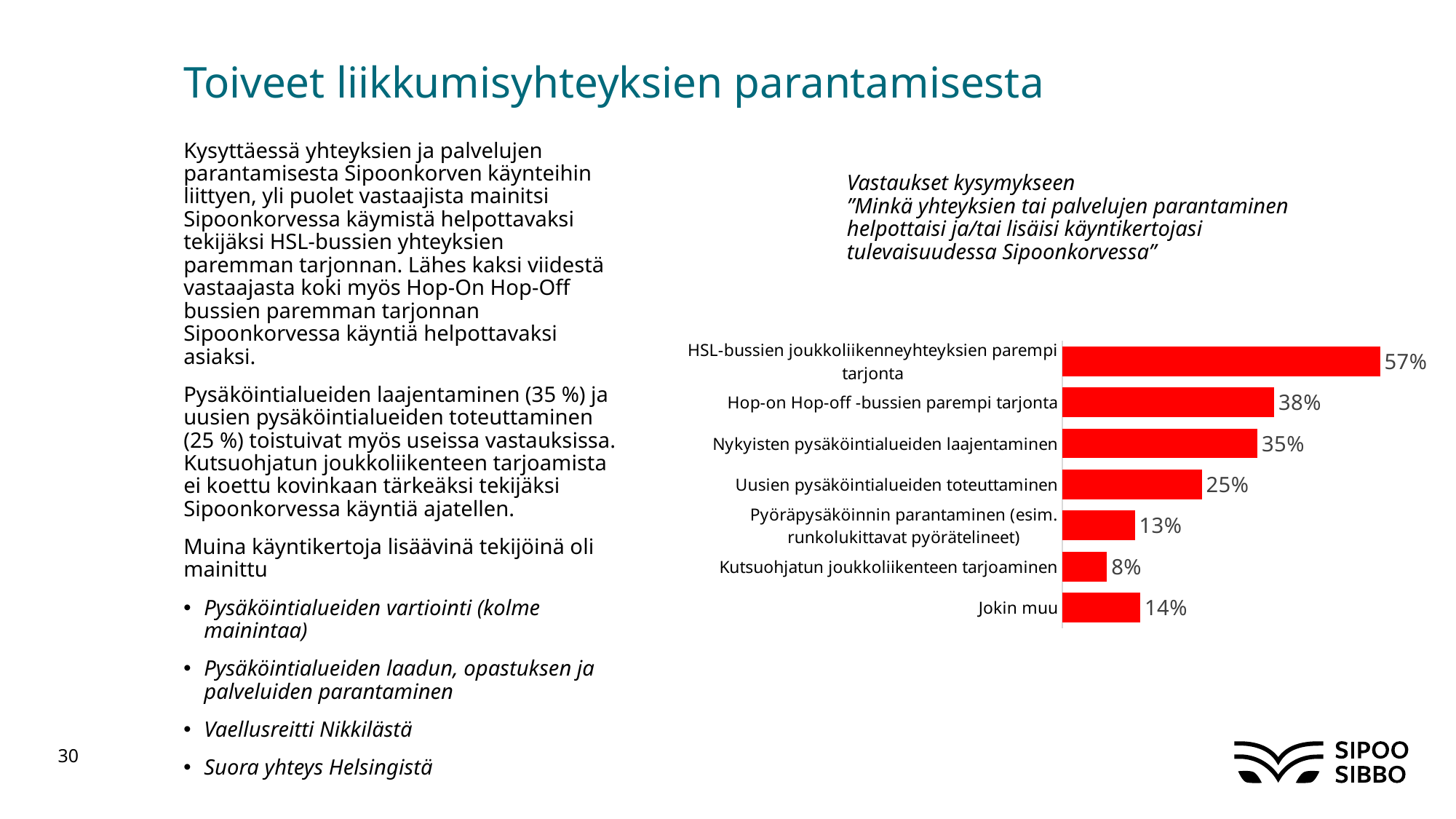
What is the value for "Hop-on Hop-off -bussien parempi tarjonta"? 38% What is the difference between "Nykyisten pysäköintialueiden laajentaminen" and "Uusien pysäköintialueiden toteuttaminen"? 10% What is the value for "Kutsuohjatun joukkoliikenteen tarjoaminen"? 8% Which category has the lowest value? Kutsuohjatun joukkoliikenteen tarjoaminen What is the value for "Jokin muu"? 14% What percentage of respondents chose "HSL-bussien joukkoliikenneyhteyksien parempi tarjonta"? 57% Which category has the highest value? HSL-bussien joukkoliikenneyhteyksien parempi tarjonta What colour are the bars in the chart? Red What kind of chart is shown on the slide? Bar chart What is the difference between the highest and lowest values in the chart? 49% How many categories are shown in the chart? 7 Which is larger: "Pyöräpysäköinnin parantaminen (esim. runkolukittavat pyörätelineet)" or "Jokin muu"? Jokin muu